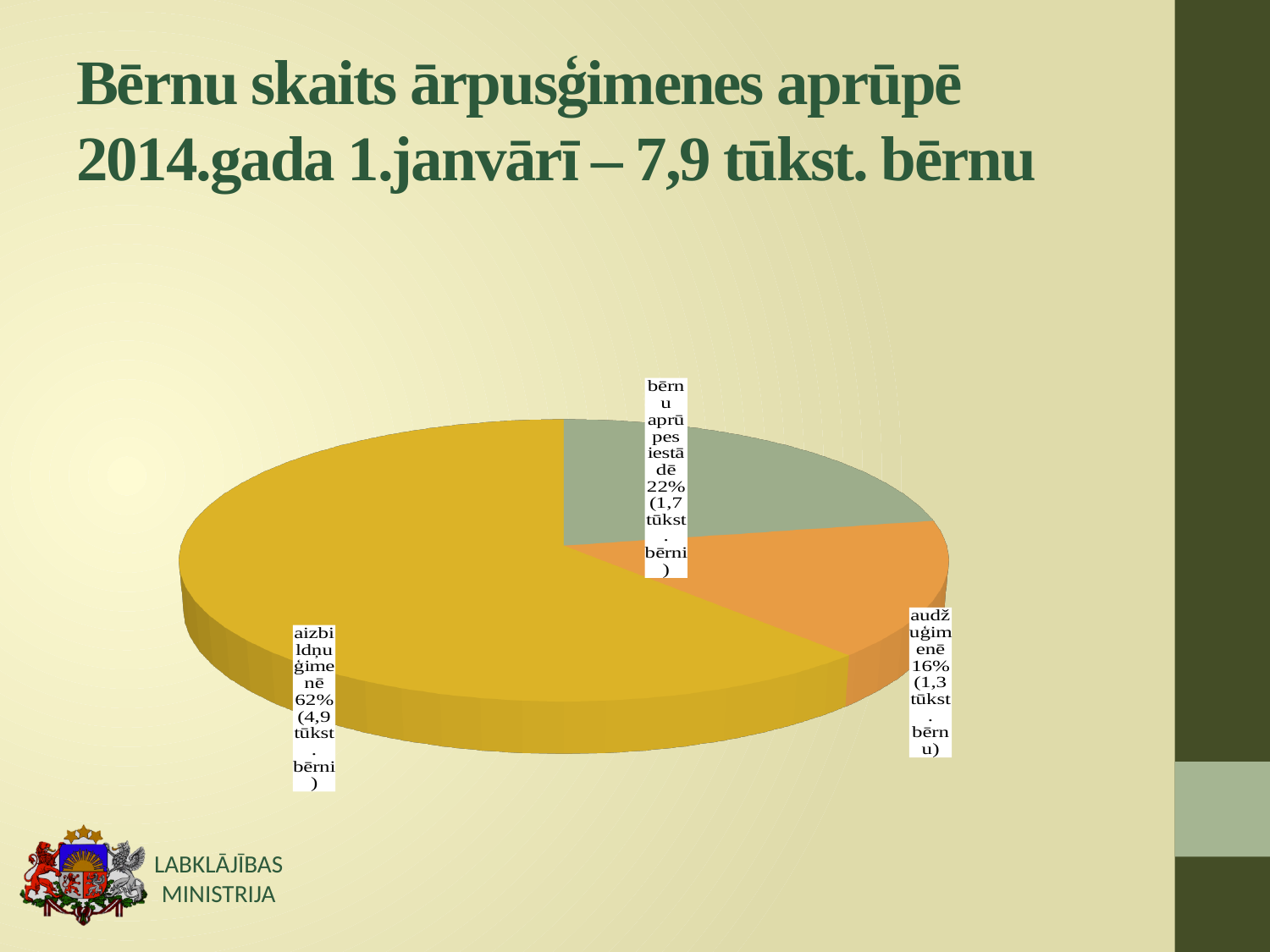
What share of the pie is labelled "bērnu aprūpes iestādē"? 22% How many slices does the pie chart have? 3 What share of the pie is labelled "aizbildņu ģimenē"? 62% How many thousand children are in the "bērnu aprūpes iestādē" slice? 1,7 tūkst. Which slice of the pie is the smallest? audžuģimenē What share of the pie is labelled "audžuģimenē"? 16% What kind of chart is shown on the slide? pie chart Which is larger, the share for "bērnu aprūpes iestādē" or the share for "audžuģimenē"? bērnu aprūpes iestādē What is the difference in percentage points between the "aizbildņu ģimenē" share and the "bērnu aprūpes iestādē" share? 40 percentage points How many thousand children are in the "audžuģimenē" slice? 1,3 tūkst. Which slice of the pie is the largest? aizbildņu ģimenē How many thousand children are in the "aizbildņu ģimenē" slice? 4,9 tūkst.